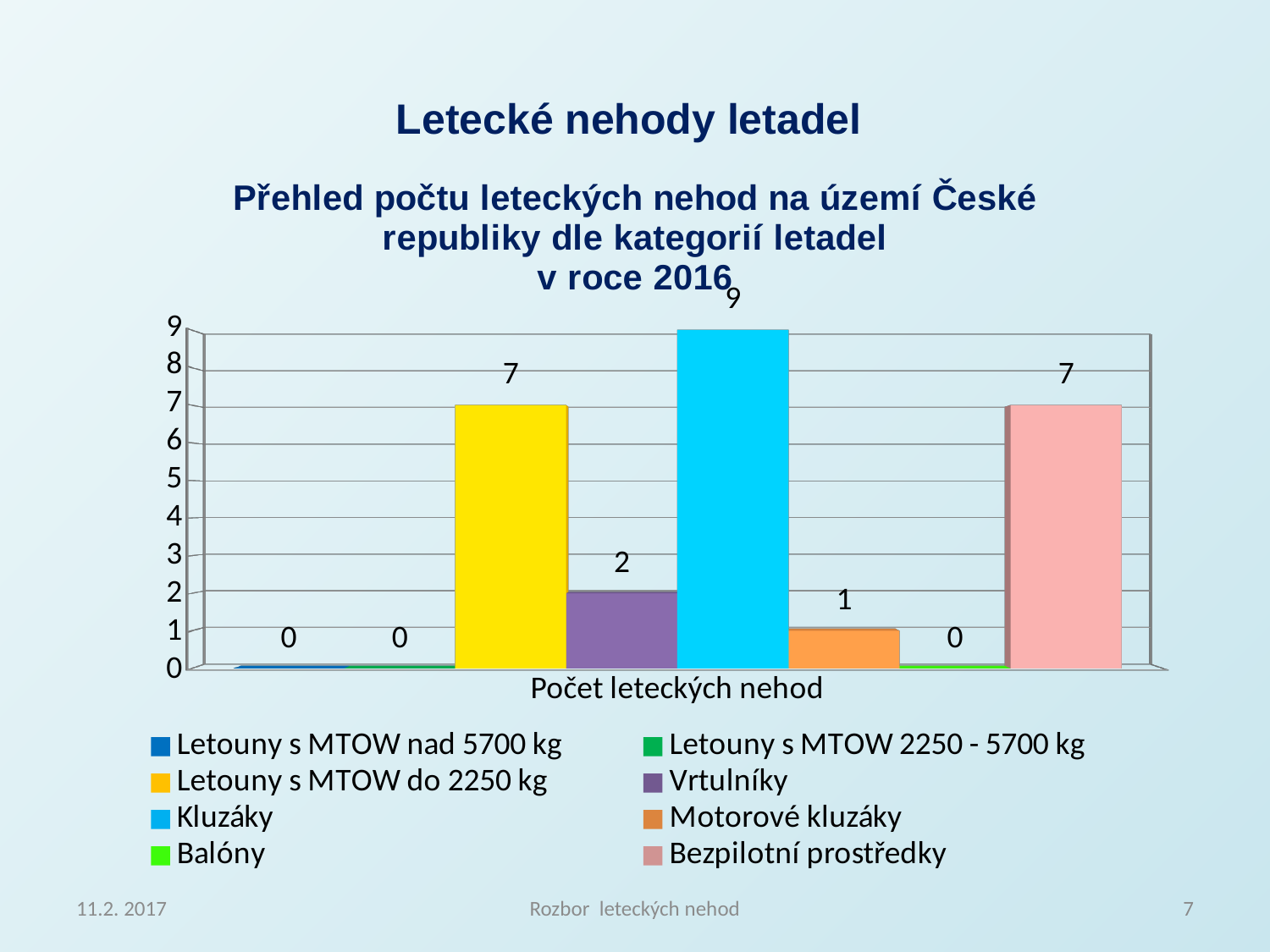
What is the value for Letouny s MTOW nad 5700 kg? 0 Which series has the highest value? Kluzáky What is the value for Kluzáky? 9 What is the difference between the values for Kluzáky and Vrtulníky? 7 What is the value for Vrtulníky? 2 What kind of chart is shown on the slide? bar chart What is the total of all the values shown in the chart? 26 Which is larger, the value for Vrtulníky or the value for Motorové kluzáky? Vrtulníky What is the value for Bezpilotní prostředky? 7 How many series does the legend list? 8 What is the value for Motorové kluzáky? 1 What is the label on the x axis of the chart? Počet leteckých nehod